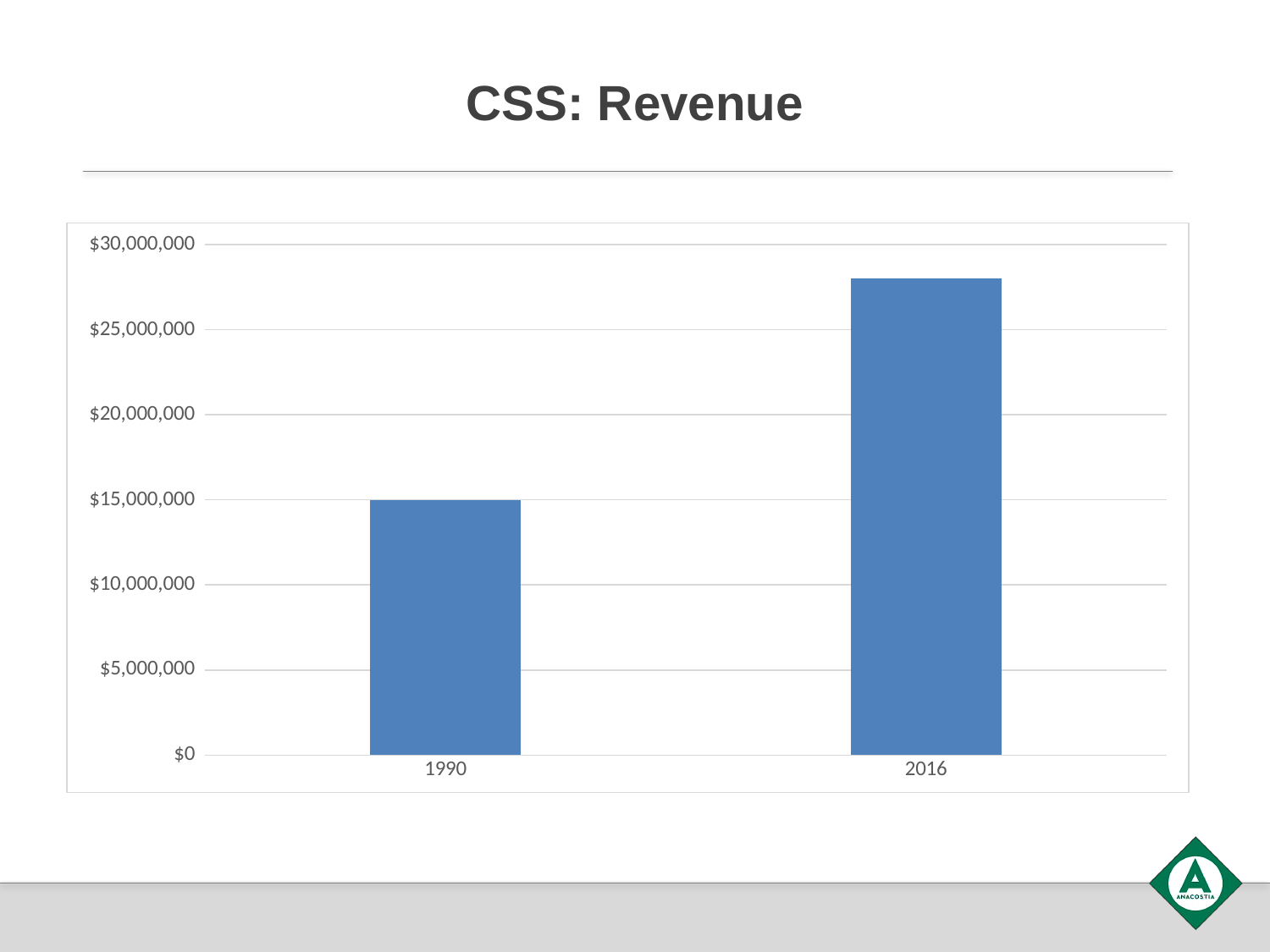
Is the value for 2016 greater or less than $30,000,000? less What is the title of the slide containing the chart? CSS: Revenue What kind of chart is shown on the slide? bar chart What is the highest value shown on the vertical axis? $30,000,000 How many bars are plotted in the chart? 2 Which is larger, the revenue for 1990 or for 2016? 2016 Do the values rise or fall from 1990 to 2016? rise Is the value for 1990 greater or less than $20,000,000? less Which year has the highest revenue? 2016 Which year has the lowest revenue? 1990 Is the value for 2016 greater or less than $25,000,000? greater What is the revenue value for 1990? $15,000,000